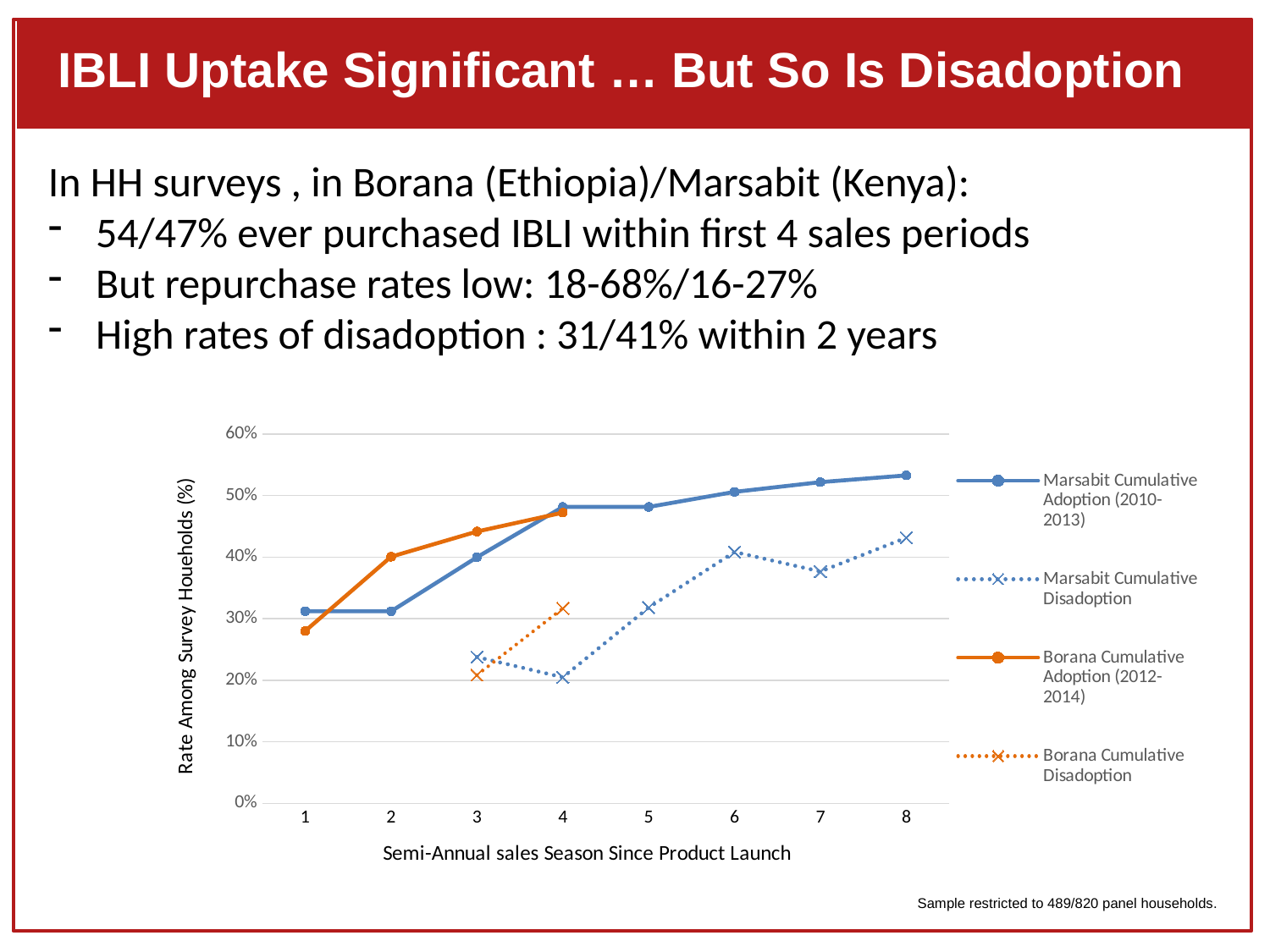
At season 2, which is higher: Borana Cumulative Adoption (2012-2014) or Marsabit Cumulative Adoption (2010-2013)? Borana Cumulative Adoption (2012-2014) Is the value for Borana Cumulative Disadoption at season 3 greater or less than 30%? less What kind of chart is shown on the slide? Line chart How many series does the chart legend list? 4 What is the title of the x axis? Semi-Annual sales Season Since Product Launch How many data points are plotted for the Marsabit Cumulative Adoption (2010-2013) series? 8 In which season is the Marsabit Cumulative Disadoption series at its lowest? 4 Is the value for Marsabit Cumulative Disadoption at season 6 greater or less than 30%? greater Is the value for Marsabit Cumulative Adoption (2010-2013) at season 8 greater or less than 50%? greater Does the Marsabit Cumulative Adoption (2010-2013) series generally rise or fall across the sales seasons? Rise How many data points are plotted for the Borana Cumulative Adoption (2012-2014) series? 4